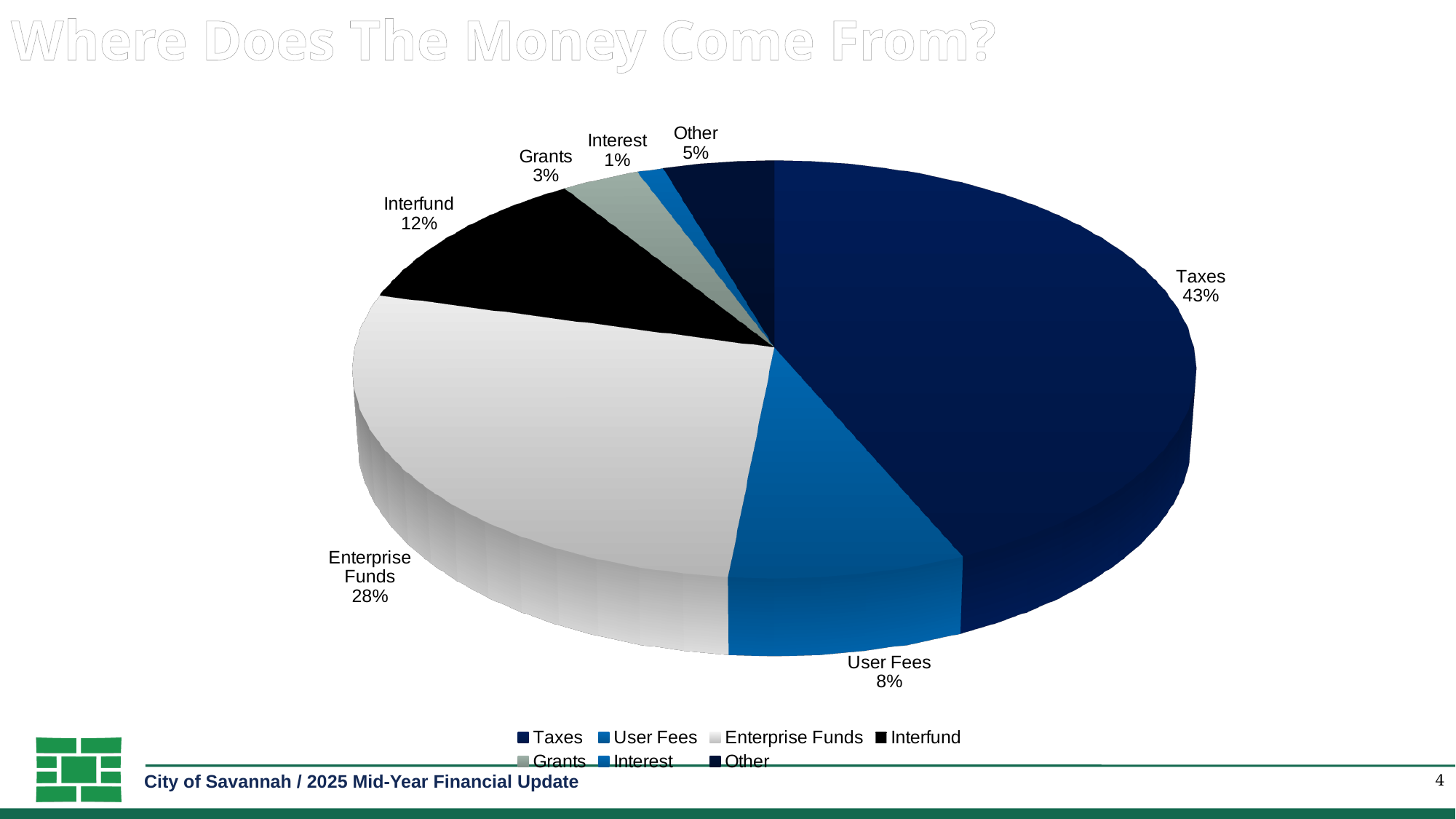
What kind of chart is shown on the slide? Pie chart Which category has the largest slice of the pie? Taxes Which category has the smallest slice of the pie? Interest What is the title of the slide? Where Does The Money Come From? What share of the pie does Taxes account for? 43% What colour is the Interfund slice? Black What is the difference in percentage points between Taxes and Enterprise Funds? 15 What percentage is shown for Enterprise Funds? 28% Which is larger, Interfund or User Fees? Interfund How many categories are shown in the pie chart? 7 What percentage is shown for Interfund? 12% What percentage is shown for User Fees? 8%